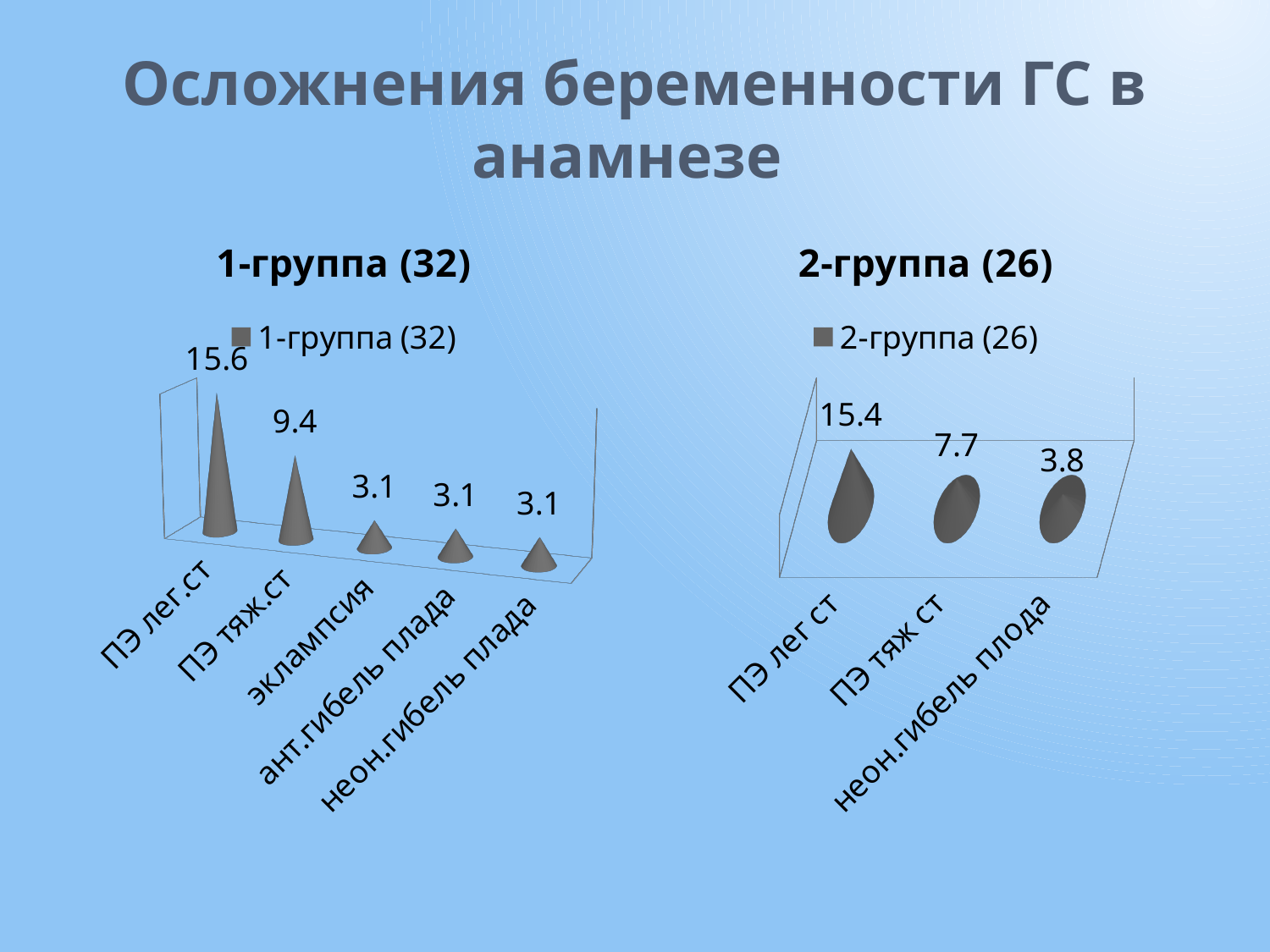
In the chart titled "1-группа (32)", which category has the highest value? ПЭ лег.ст In the chart titled "1-группа (32)", what is the difference between the values for ПЭ лег.ст and ПЭ тяж.ст? 6.2 In the chart titled "2-группа (26)", what is the value for неон.гибель плода? 3.8 In the chart titled "2-группа (26)", which category has the lowest value? неон.гибель плода In the chart titled "2-группа (26)", what is the value for ПЭ тяж ст? 7.7 In the chart titled "1-группа (32)", what is the value for ПЭ лег.ст? 15.6 In the chart titled "2-группа (26)", how many categories are shown? 3 In the chart titled "1-группа (32)", what is the value for ПЭ тяж.ст? 9.4 In the chart titled "1-группа (32)", how many categories are shown? 5 What kind of chart is the chart titled "2-группа (26)"? bar chart In the chart titled "1-группа (32)", what is the value for эклампсия? 3.1 Which is larger: the value for ПЭ лег.ст in the "1-группа (32)" chart or the value for ПЭ лег ст in the "2-группа (26)" chart? ПЭ лег.ст in 1-группа (32)